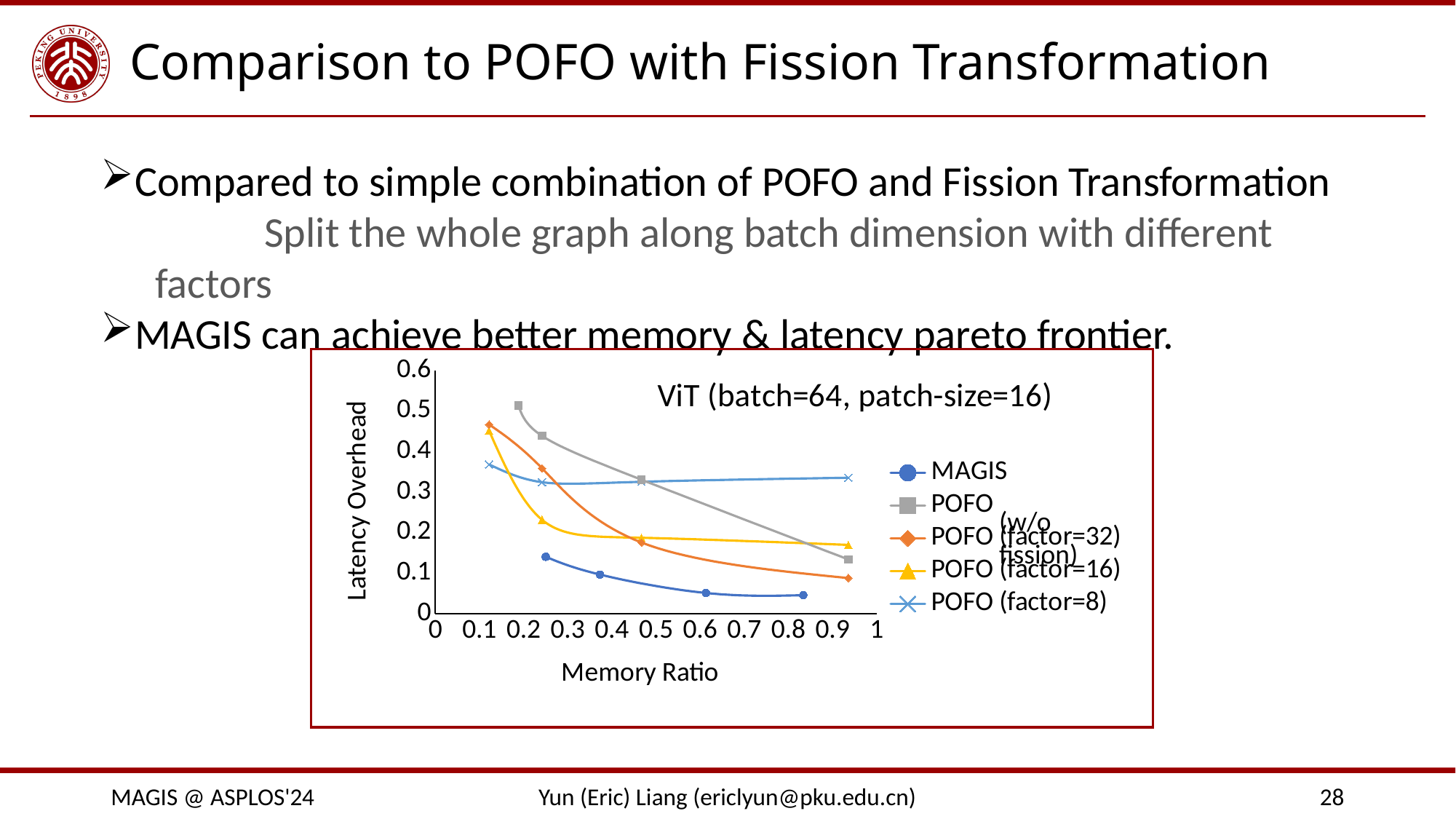
Which series has the lowest latency overhead across the plotted memory ratios? MAGIS Is the latency overhead of the first MAGIS point (at memory ratio about 0.25) greater or less than 0.2? less What is the label of the y axis? Latency Overhead At a memory ratio of about 0.95, which series has the higher latency overhead: POFO (factor=8) or POFO (factor=32)? POFO (factor=8) Does the latency overhead of the MAGIS series rise or fall as the memory ratio increases? fall How many data points are plotted for the MAGIS series? 4 Is the latency overhead of the first POFO (w/o fission) point greater or less than 0.4? greater How many series does the legend list? 5 How many data points are plotted for the POFO (factor=8) series? 4 What kind of chart is shown on the slide? line chart What is the title shown inside the chart? ViT (batch=64, patch-size=16) Is the latency overhead of the last POFO (factor=16) point (near memory ratio 0.95) greater or less than 0.2? less